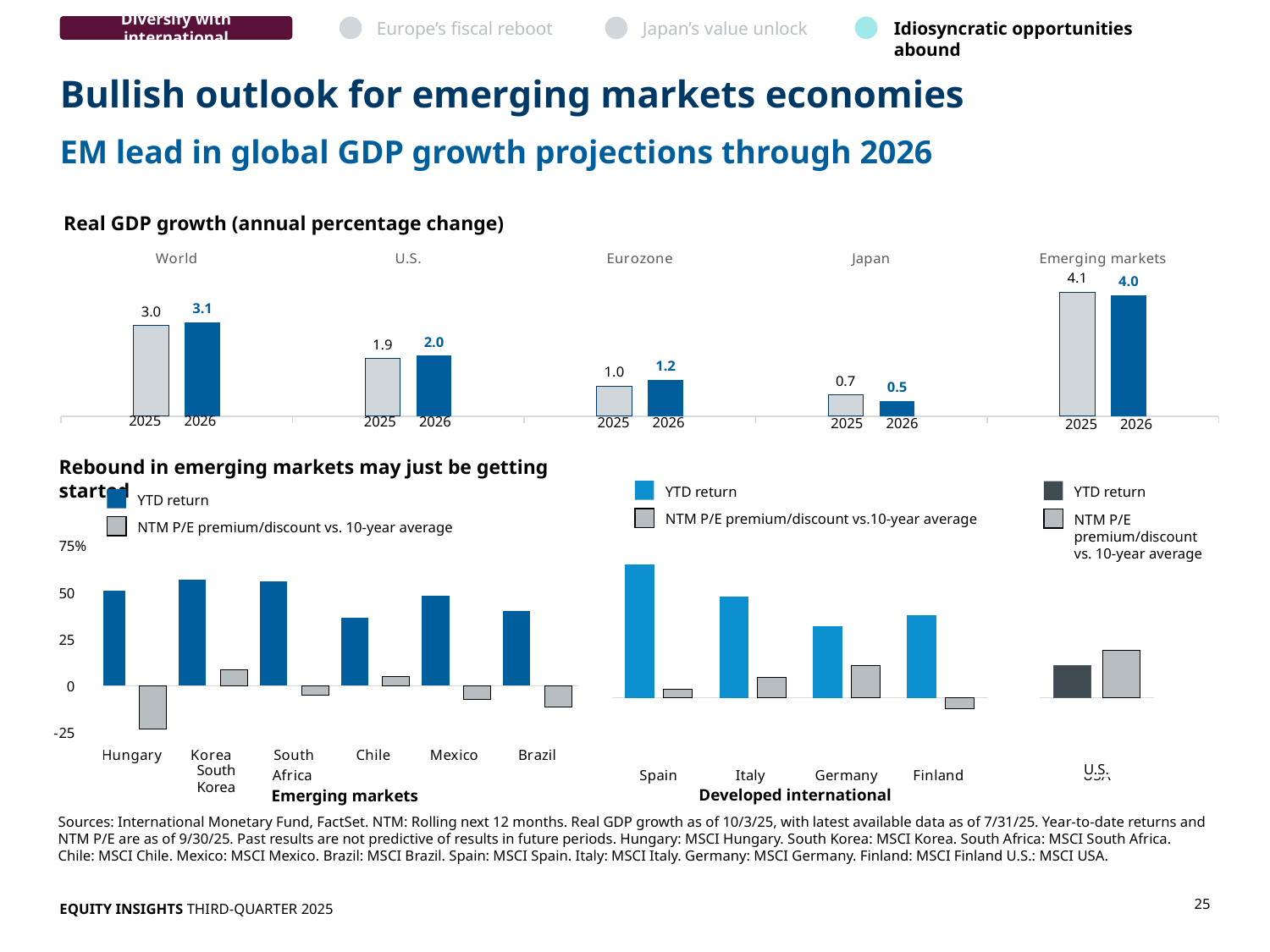
In the bottom chart's Developed international panel, which country has the highest YTD return? Spain In the bottom chart, how many countries are shown in the Emerging markets panel? 6 In the Real GDP growth chart, is the 2026 value for Japan higher or lower than its 2025 value? lower In the Real GDP growth chart, what is the 2026 value for Emerging markets? 4.0 In the Real GDP growth chart, which region has the lowest 2026 value? Japan In the bottom chart, is the NTM P/E premium/discount for Hungary greater or less than 0? less How many regions are shown in the Real GDP growth chart? 5 In the Real GDP growth chart, which region has the highest 2025 value? Emerging markets In the Real GDP growth chart, what is the 2025 value for Japan? 0.7 In the Real GDP growth chart, what is the 2026 value for the Eurozone? 1.2 In the Real GDP growth chart, what is the difference between the 2026 and 2025 values for the U.S.? 0.1 In the bottom chart, is the YTD return for Spain greater or less than 50? greater